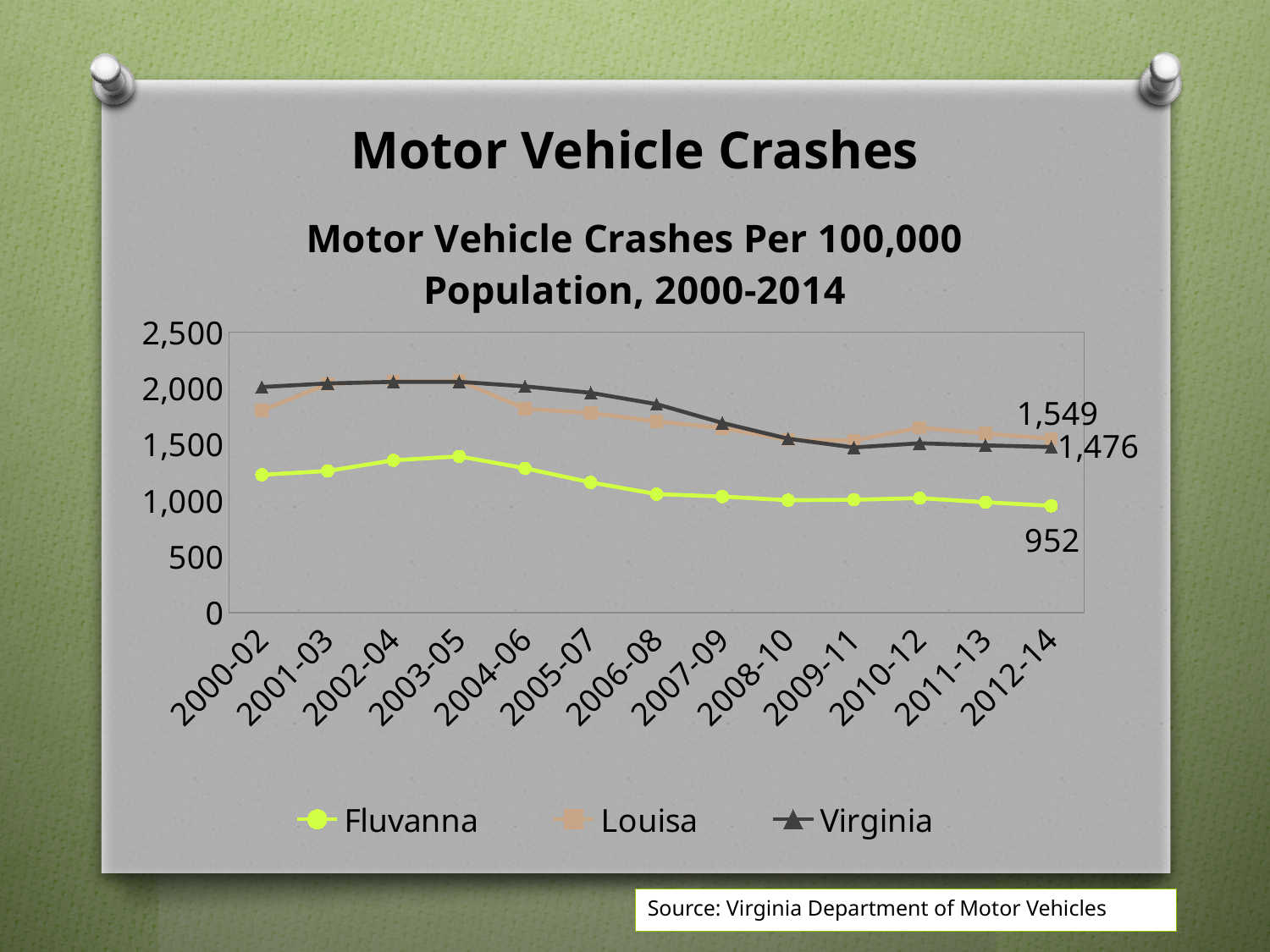
Which series has the lowest value in 2012-14? Fluvanna What is the value for Louisa in 2012-14? 1,549 How many periods are shown along the x axis? 13 Is the value for Fluvanna in 2003-05 greater or less than 1,500? less What kind of chart is shown on the slide? line chart What is the value for Fluvanna in 2012-14? 952 What is the value for Virginia in 2012-14? 1,476 How many series does the legend list? 3 What is the difference between the Louisa and Virginia values in 2012-14? 73 What is the title of the chart? Motor Vehicle Crashes Per 100,000 Population, 2000-2014 What is the difference between the Louisa and Fluvanna values in 2012-14? 597 Does the Virginia series generally rise or fall from 2003-05 to 2012-14? fall